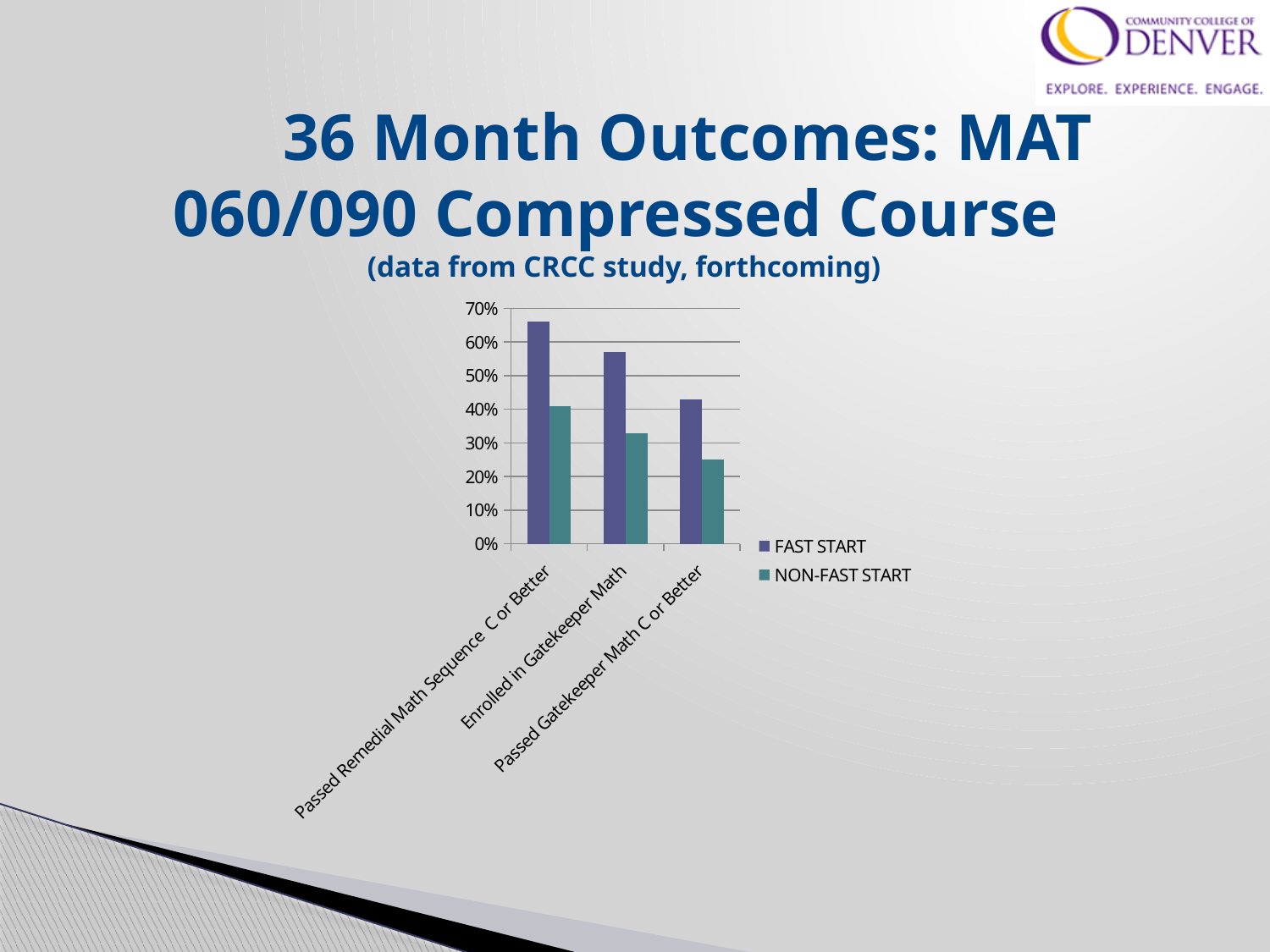
Is the FAST START value for 'Passed Remedial Math Sequence C or Better' greater or less than 60%? greater What kind of chart is shown on the slide? Bar chart Which category has the highest FAST START value? Passed Remedial Math Sequence C or Better Is the FAST START value for 'Enrolled in Gatekeeper Math' greater or less than 50%? greater Is the NON-FAST START value for 'Enrolled in Gatekeeper Math' greater or less than 40%? less For 'Passed Gatekeeper Math C or Better', which is larger: FAST START or NON-FAST START? FAST START Which series has the highest bar for 'Passed Remedial Math Sequence C or Better'? FAST START Which category has the lowest NON-FAST START value? Passed Gatekeeper Math C or Better How many categories are shown on the x axis? 3 How many series does the legend list? 2 Do the FAST START values rise or fall across the categories from left to right? fall